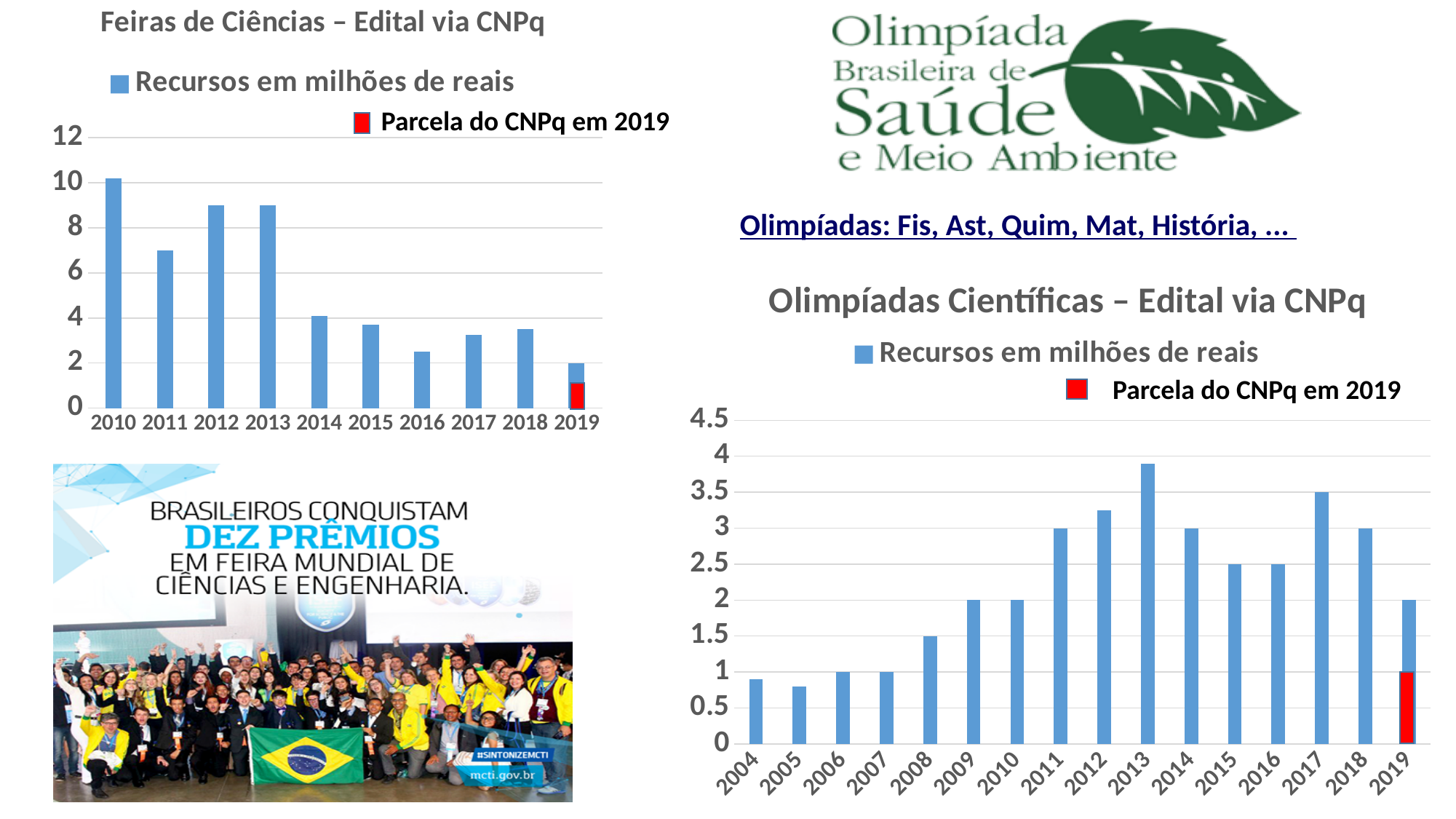
In the 'Feiras de Ciências – Edital via CNPq' chart, is the value for 2015 greater or less than 4? less In the 'Feiras de Ciências – Edital via CNPq' chart, how many years are shown on the x axis? 10 How many series does the legend of the 'Olimpíadas Científicas – Edital via CNPq' chart list? 2 In the 'Feiras de Ciências – Edital via CNPq' chart, do the values generally rise or fall from 2010 to 2019? fall In the 'Olimpíadas Científicas – Edital via CNPq' chart, what is the value for Recursos em milhões de reais in 2017? 3.5 In the 'Feiras de Ciências – Edital via CNPq' chart, which year has the highest value for Recursos em milhões de reais? 2010 In the 'Feiras de Ciências – Edital via CNPq' chart, which year has the lowest value for Recursos em milhões de reais? 2019 In the 'Olimpíadas Científicas – Edital via CNPq' chart, what is the difference between the values for 2017 and 2019? 1.5 In the 'Olimpíadas Científicas – Edital via CNPq' chart, which year has the highest value for Recursos em milhões de reais? 2013 In the 'Feiras de Ciências – Edital via CNPq' chart, is the value for 2010 greater or less than 10? greater In the 'Olimpíadas Científicas – Edital via CNPq' chart, what is the value for Recursos em milhões de reais in 2019? 2 In the 'Feiras de Ciências – Edital via CNPq' chart, which is larger, the value for 2012 or the value for 2016? 2012